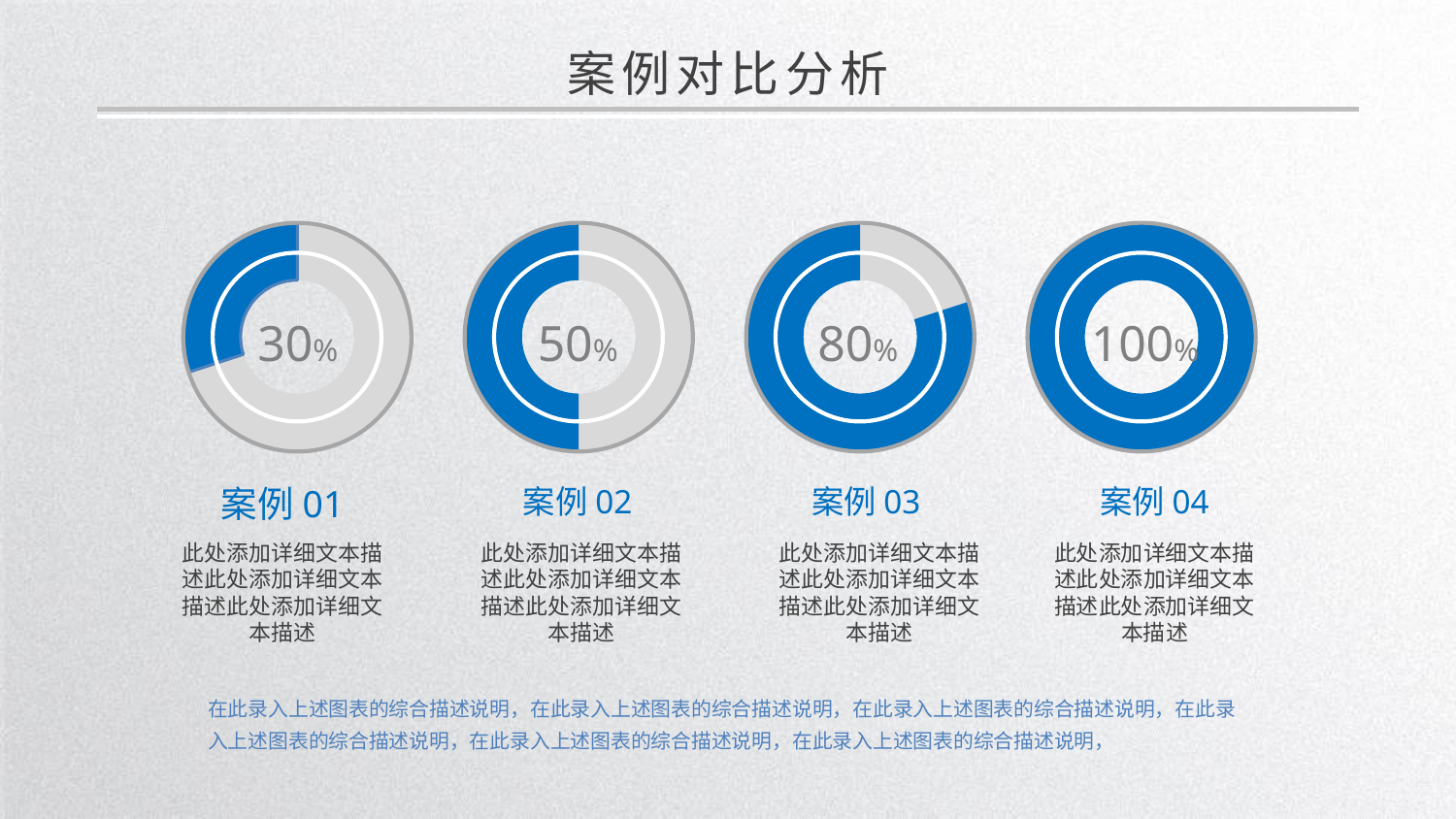
What kind of chart is used to show each case's percentage on the slide? Donut chart What value is shown in the donut chart for 案例 03? 80% What value is shown in the donut chart for 案例 04? 100% What value is shown in the donut chart for 案例 01? 30% What value is shown in the donut chart for 案例 02? 50% How many donut charts are shown on the slide? 4 What is the difference between the percentage for 案例 03 and the percentage for 案例 01? 50% Which case (案例) has the highest percentage among the four donut charts? 案例 04 What is the difference between the percentage for 案例 04 and the percentage for 案例 02? 50% Which case (案例) has the lowest percentage among the four donut charts? 案例 01 What is the title of the slide containing the four donut charts? 案例对比分析 Which has a larger percentage, 案例 02 or 案例 03? 案例 03